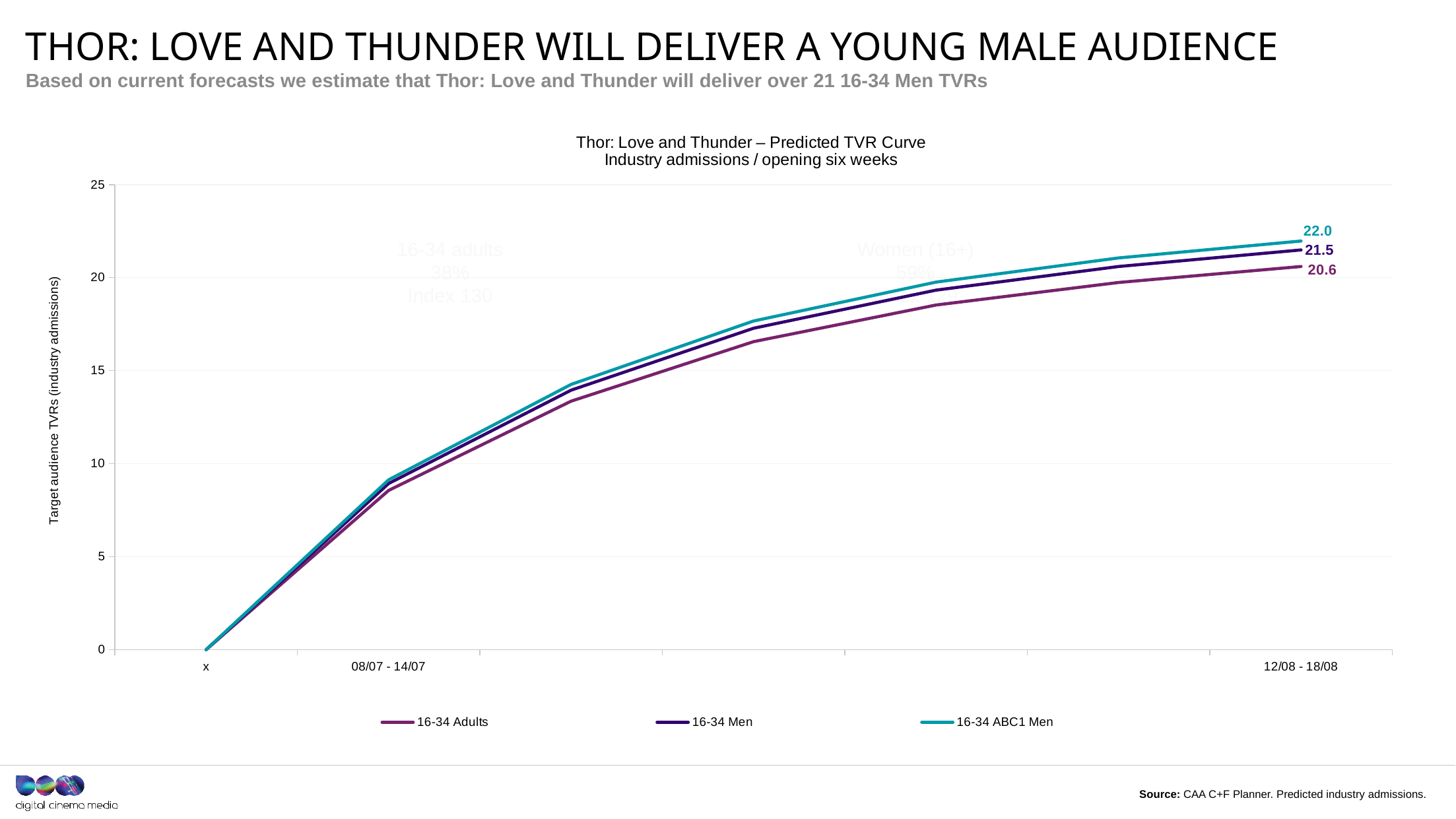
What is the difference between the final values for 16-34 ABC1 Men and 16-34 Adults? 1.4 Which series has the highest value at the end of the curve? 16-34 ABC1 Men What is the final value shown for 16-34 Men at 12/08 - 18/08? 21.5 What kind of chart is shown on the slide? line chart What is the difference between the final values for 16-34 Men and 16-34 Adults? 0.9 What is the final value shown for 16-34 Adults at 12/08 - 18/08? 20.6 How many series does the legend list? 3 What is the final value shown for 16-34 ABC1 Men at 12/08 - 18/08? 22.0 Do the values rise or fall along the x axis? rise Is the value for 16-34 Men at 08/07 - 14/07 greater or less than 10? less Which series has the lowest value at the end of the curve? 16-34 Adults At 12/08 - 18/08, which is larger: 16-34 Men or 16-34 Adults? 16-34 Men